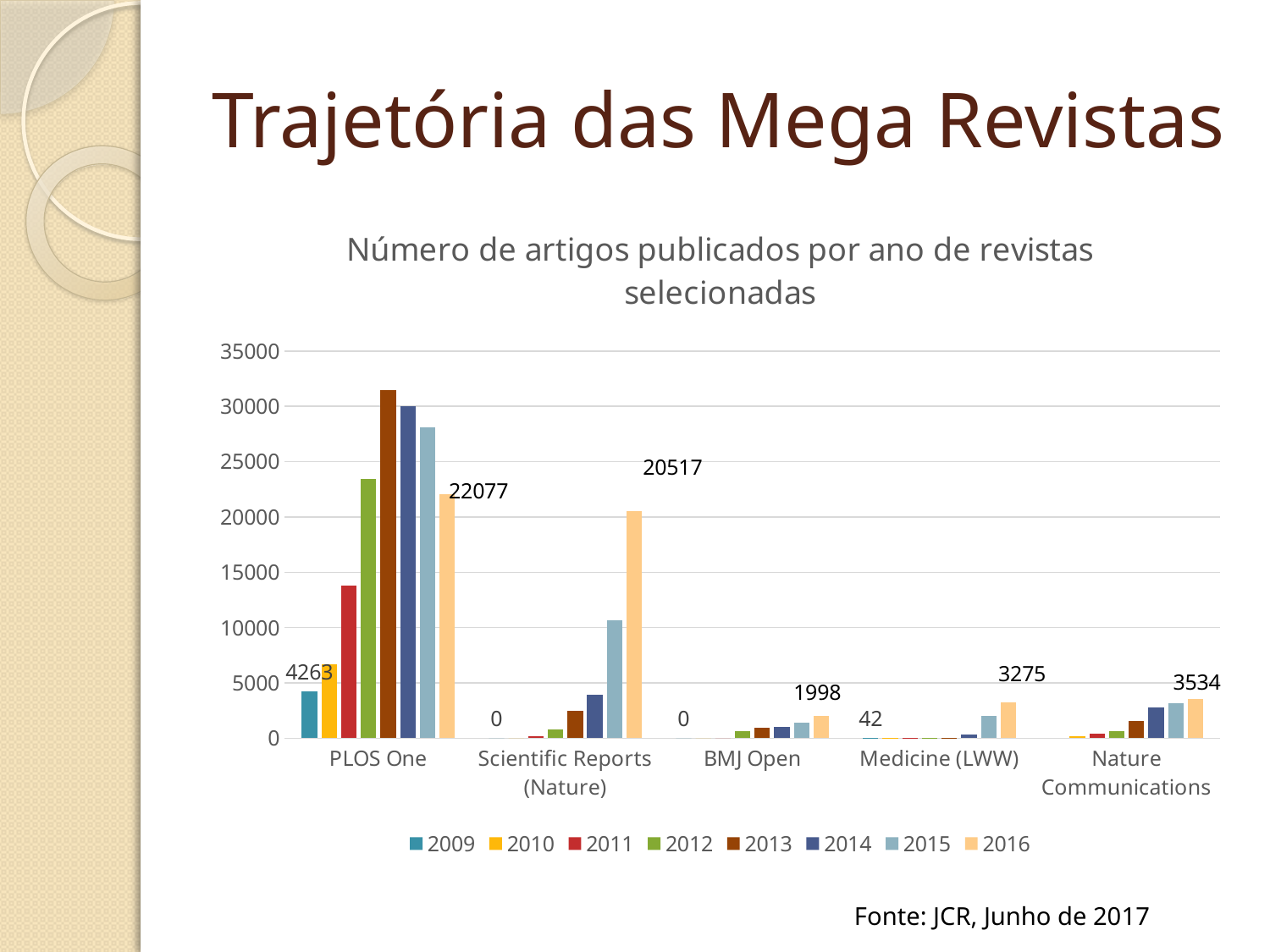
What kind of chart is shown on the slide? bar chart Which journal has the highest value in 2016? PLOS One What is the value for PLOS One in 2009? 4263 How many series does the legend list? 8 How many journals are shown on the x axis? 5 What is the difference between the 2016 values for Scientific Reports (Nature) and BMJ Open? 18519 What is the value for Scientific Reports (Nature) in 2016? 20517 Is the value for PLOS One in 2013 greater or less than 30000? greater What is the difference between the PLOS One values for 2016 and 2009? 17814 What is the value for PLOS One in 2016? 22077 Which has the larger 2016 value, Nature Communications or Medicine (LWW)? Nature Communications What is the value for Medicine (LWW) in 2009? 42